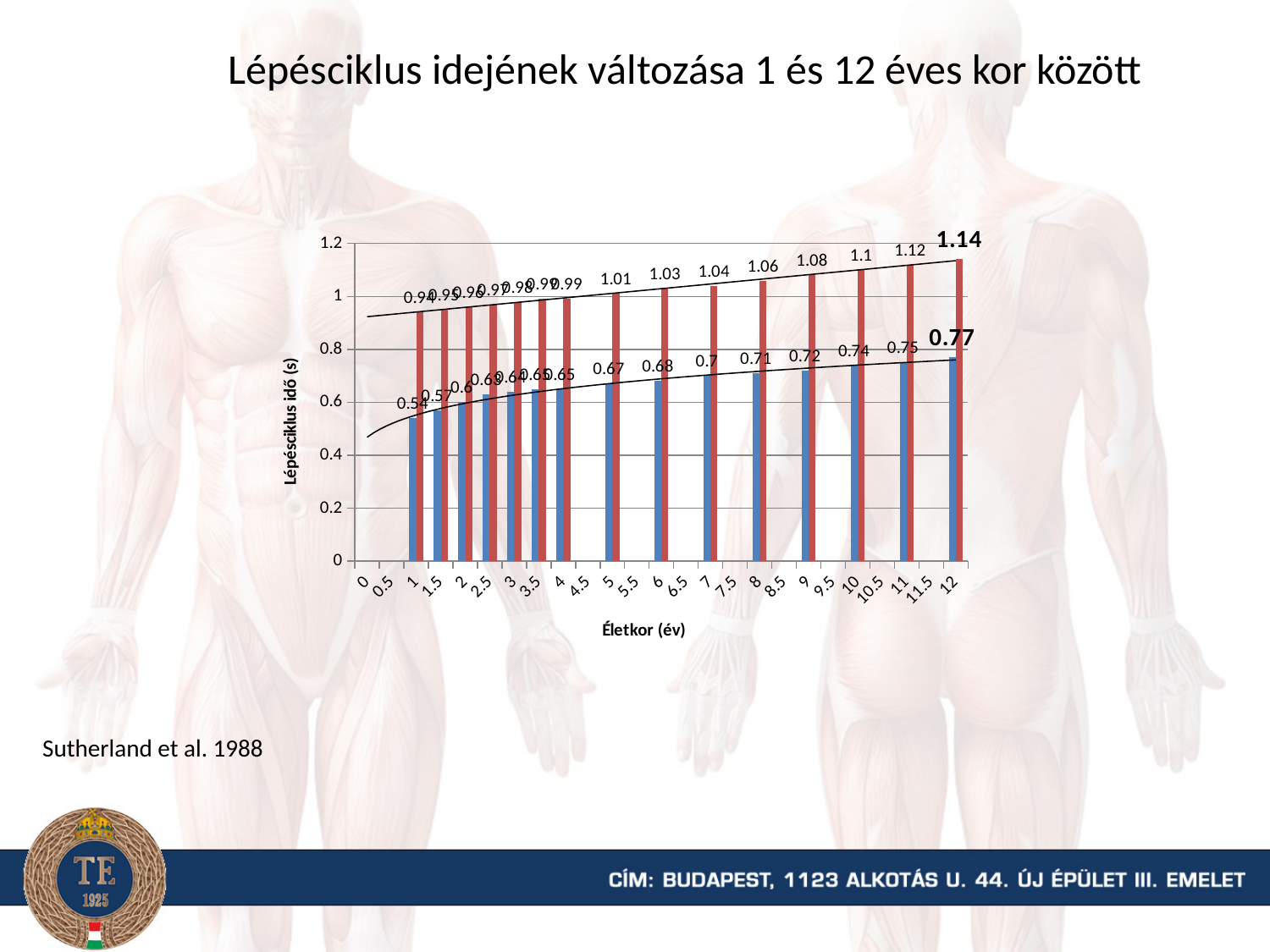
What is the difference between the red and blue bar values at age 12? 0.37 What is the value of the red bar at age 12? 1.14 At which age is the red bar highest? 12 Which is larger at age 8: the red bar or the blue bar? the red bar At which age is the blue bar lowest? 1 What is the value of the blue bar at age 1? 0.54 What kind of chart is shown on the slide? bar chart What is the value of the red bar at age 5? 1.01 Is the value of the blue bar at age 7 greater or less than 0.6? greater What is the value of the blue bar at age 9? 0.72 What is the value of the blue bar at age 12? 0.77 Do the red bar values rise or fall as age increases from 1 to 12? rise